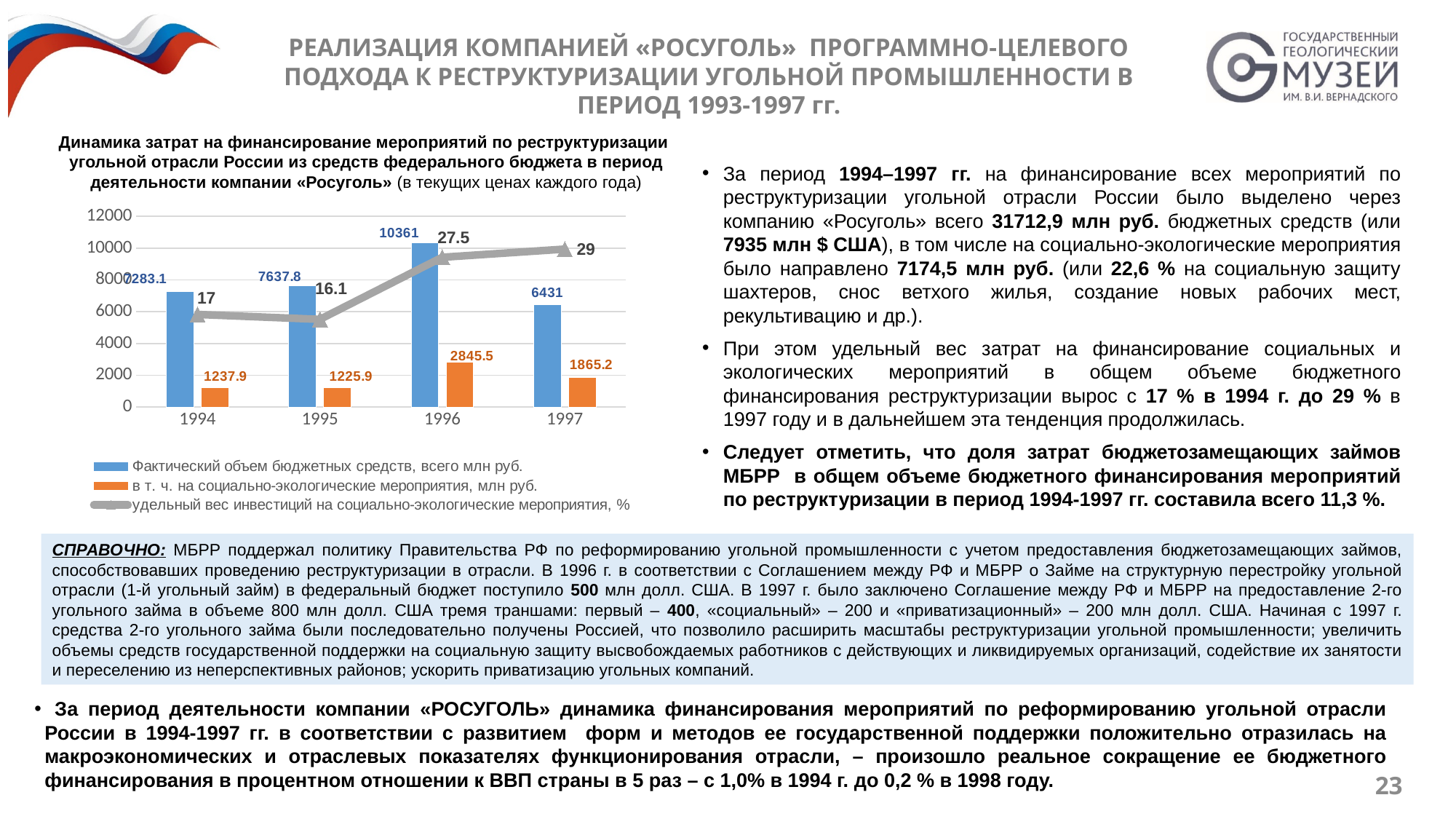
How many years are shown on the x axis of the chart? 4 Does the 'удельный вес инвестиций на социально-экологические мероприятия, %' series rise or fall from 1995 to 1997? rise In which year is 'в т. ч. на социально-экологические мероприятия, млн руб.' the lowest? 1995 What kind of chart is shown on the slide? Combined bar and line chart How many series does the chart legend list? 3 What is the value of 'удельный вес инвестиций на социально-экологические мероприятия, %' for 1995? 16.1 In which year is 'Фактический объем бюджетных средств, всего млн руб.' the highest? 1996 Is the value of 'Фактический объем бюджетных средств, всего млн руб.' for 1997 greater or less than 8000? less What is the difference between the 'Фактический объем бюджетных средств, всего млн руб.' values for 1996 and 1997? 3930 What is the value of 'в т. ч. на социально-экологические мероприятия, млн руб.' for 1997? 1865.2 Which year has the larger value for 'в т. ч. на социально-экологические мероприятия, млн руб.': 1996 or 1997? 1996 What is the value of 'Фактический объем бюджетных средств, всего млн руб.' for 1996? 10361